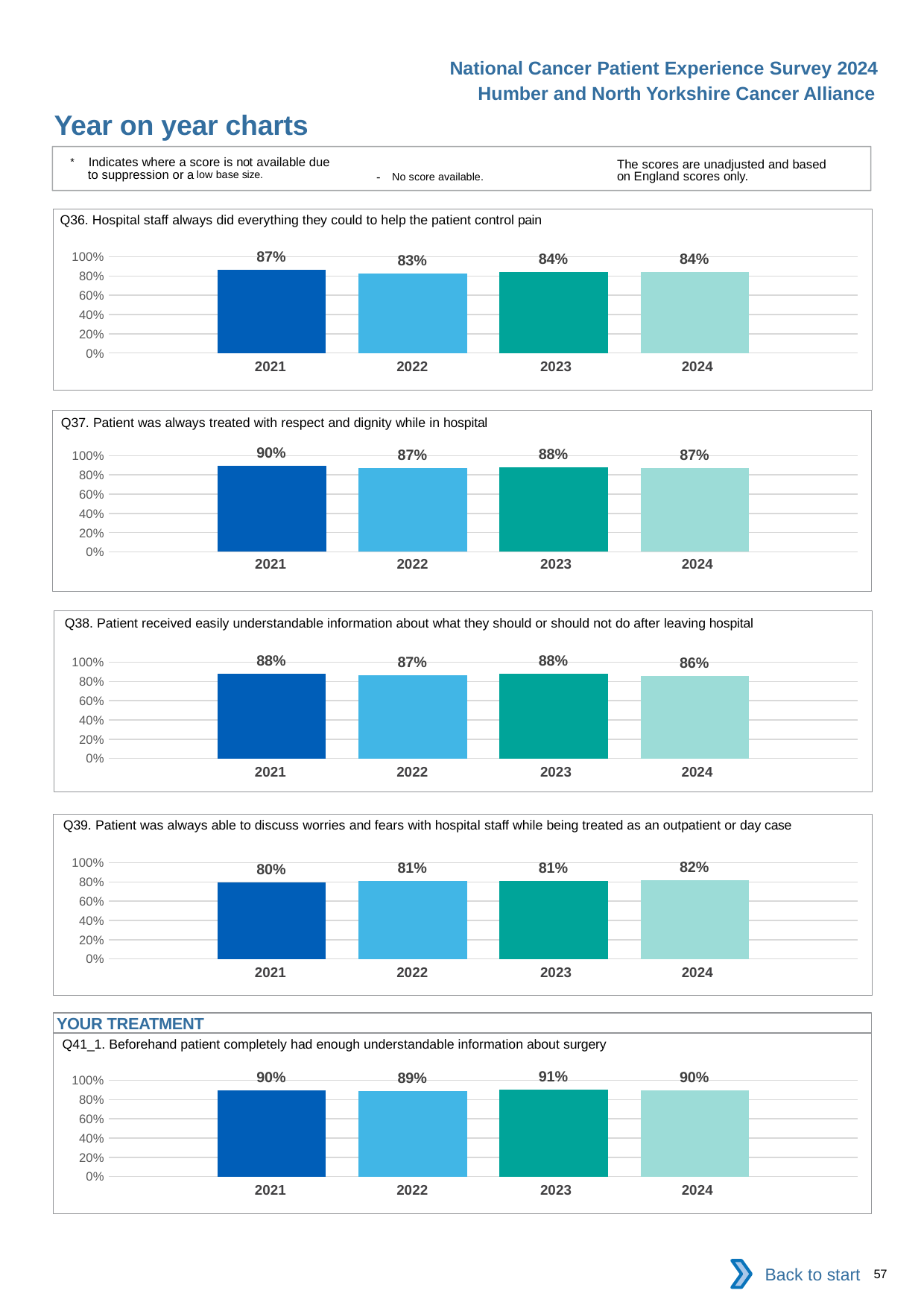
In the Q41_1 chart, which year has the highest value? 2023 In the Q38 chart, what is the value for 2024? 86% In the Q39 chart, do the values generally rise or fall from 2021 to 2024? rise In the Q37 chart, what is the difference between the 2021 and 2022 values? 3% In the Q38 chart, which is larger, the value for 2021 or the value for 2024? 2021 In the Q39 chart, what is the value for 2021? 80% How many years are shown in the Q36 chart? 4 In the Q37 chart, which year has the highest value? 2021 In the Q36 chart, which year has the lowest value? 2022 What kind of chart is the Q37 chart? bar chart In the Q36 chart, what is the value for 2021? 87% In the Q41_1 chart, what is the value for 2022? 89%